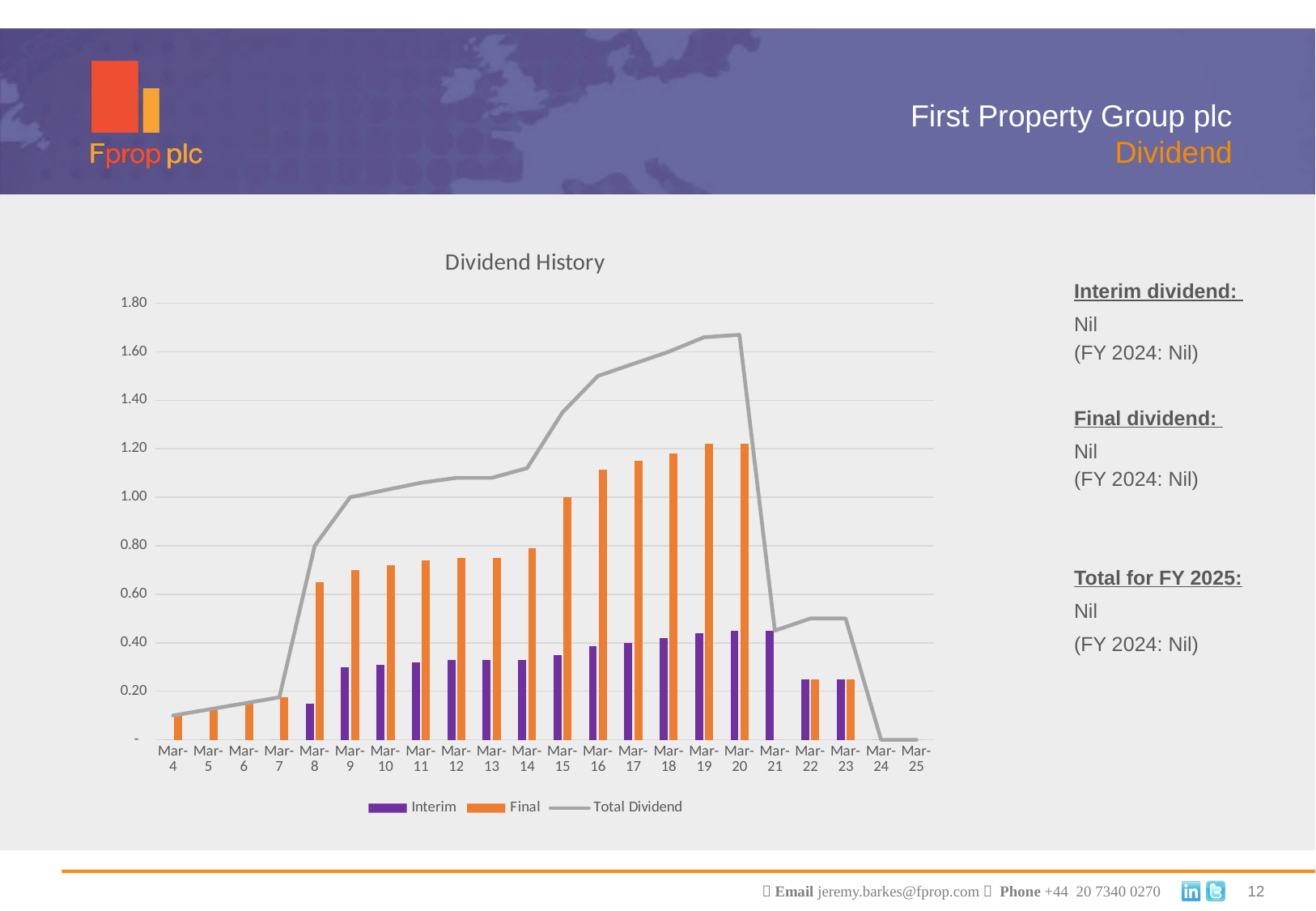
What kind of chart is the Dividend History chart? Bar chart with a line series How many series does the chart legend list? 3 How many categories are shown on the x axis of the Dividend History chart? 22 Is the Final dividend value for Mar-16 greater or less than 1.00? greater Does the Total Dividend line rise or fall from Mar-4 to Mar-20? rise Is the Final dividend value for Mar-9 greater or less than 0.60? greater Which is larger: the Final dividend for Mar-10 or the Final dividend for Mar-14? Mar-14 What is the title of the chart? Dividend History Which series is shown in orange in the chart legend? Final Is the Total Dividend value for Mar-24 greater or less than 0.20? less Which is larger for Mar-16: the Interim dividend or the Final dividend? Final